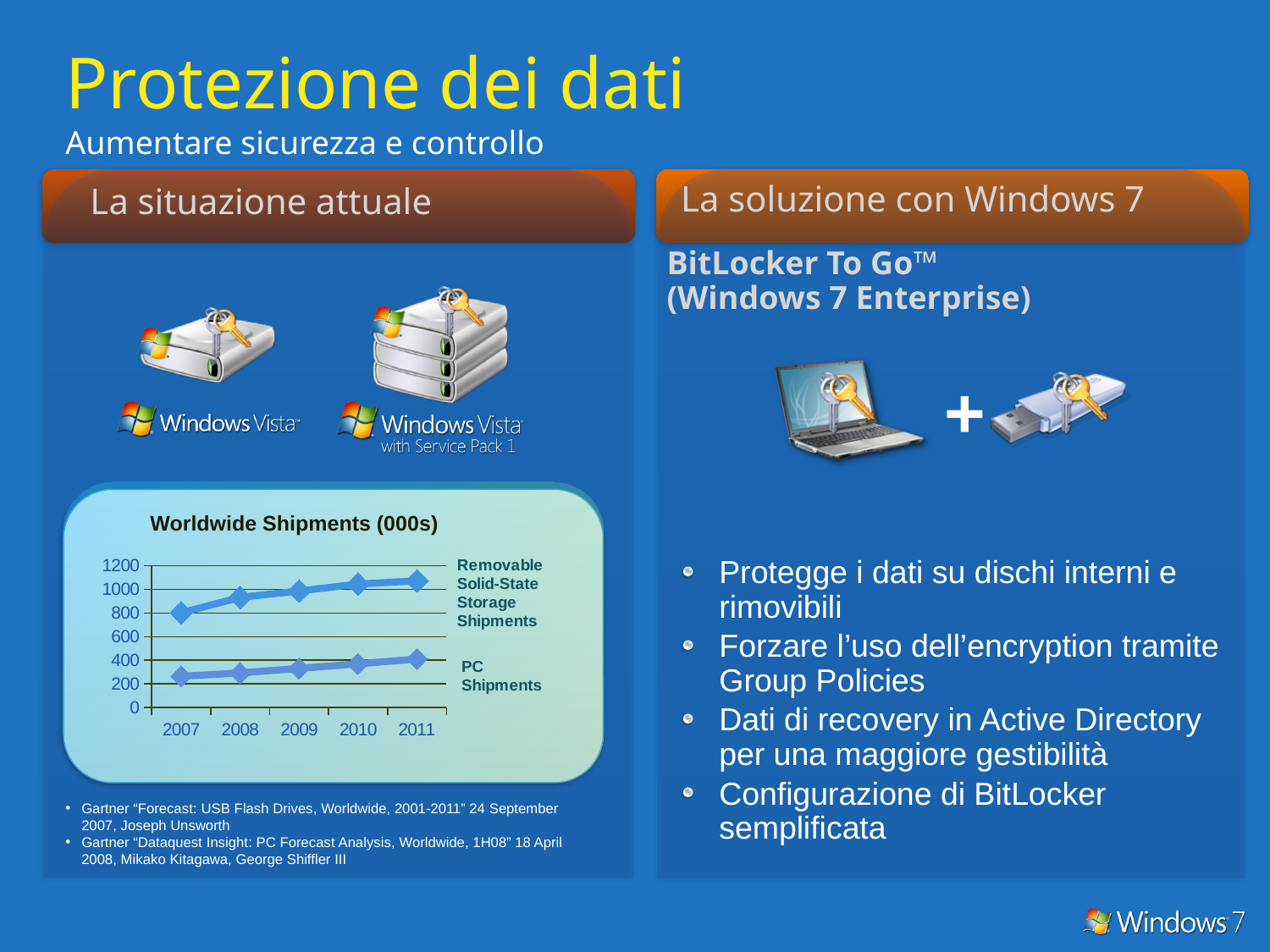
Do the Removable Solid-State Storage Shipments values rise or fall from 2007 to 2011? rise Is the value for Removable Solid-State Storage Shipments in 2011 greater or less than 1000? greater How many series does the legend of the "Worldwide Shipments (000s)" chart list? 2 Is the value for PC Shipments in 2007 greater or less than 400? less Is the value for Removable Solid-State Storage Shipments in 2007 greater or less than 1000? less Do the PC Shipments values rise or fall from 2007 to 2011? rise Which two series are listed in the legend of the "Worldwide Shipments (000s)" chart? Removable Solid-State Storage Shipments and PC Shipments In which year is the Removable Solid-State Storage Shipments value lowest? 2007 In 2009, which series has the larger value: Removable Solid-State Storage Shipments or PC Shipments? Removable Solid-State Storage Shipments What is the title of the chart on the slide? Worldwide Shipments (000s) How many years are shown on the x axis of the "Worldwide Shipments (000s)" chart? 5 What kind of chart is shown under the title "Worldwide Shipments (000s)"? line chart